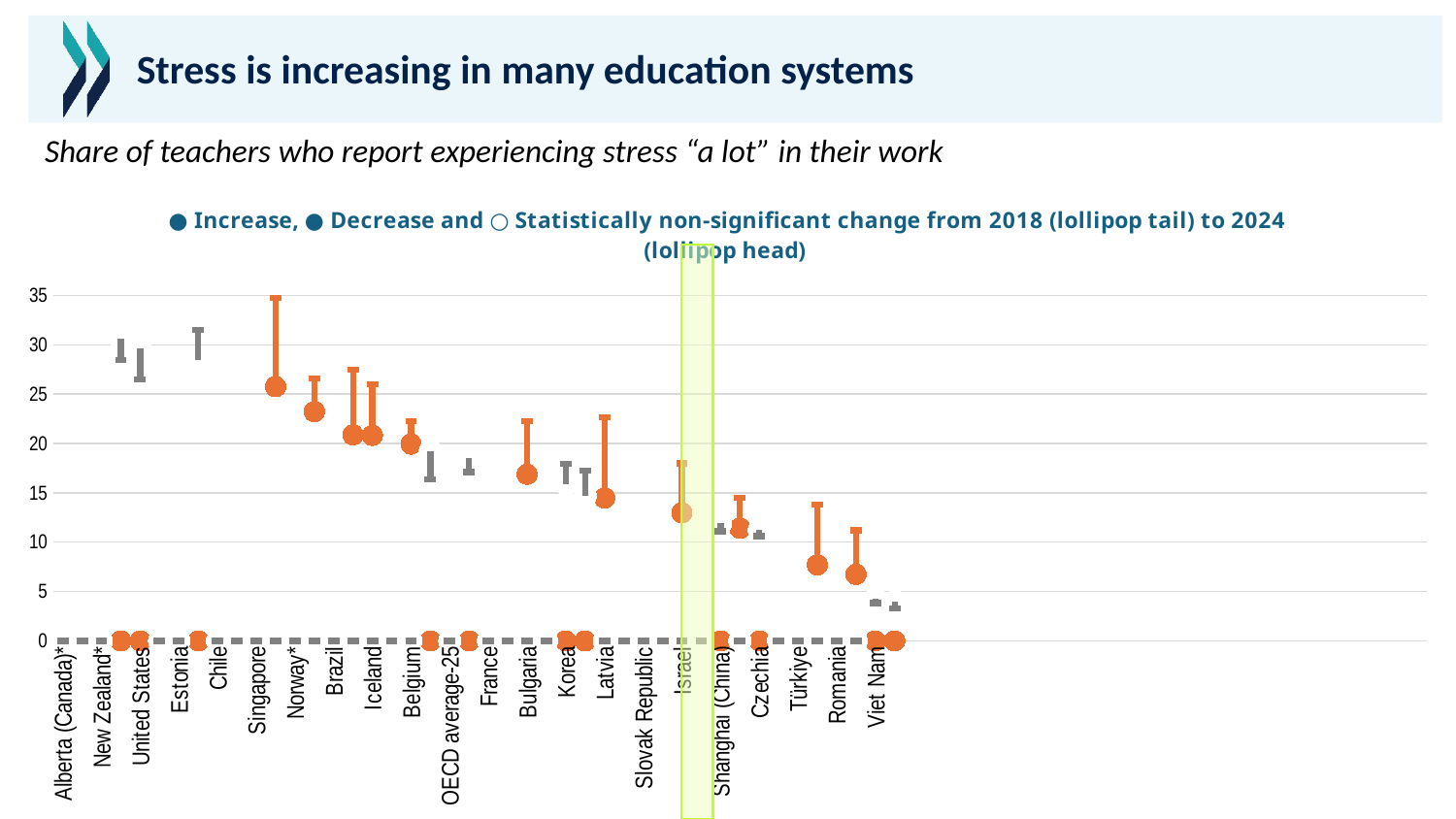
What does the chart measure, according to the subtitle? Share of teachers who report experiencing stress "a lot" in their work Is the 2024 value (lollipop head) for Latvia greater or less than 20? less How many countries or economies are listed along the x axis? 22 What kind of chart is shown on the slide? Lollipop chart Is the 2024 value (lollipop head) for Israel greater or less than 10? greater Which has the larger 2024 value (lollipop head), Norway or Türkiye? Norway Which has the larger 2024 value (lollipop head), Singapore or Romania? Singapore What is the title of the slide? Stress is increasing in many education systems Do the values generally rise or fall moving from left to right along the x axis? fall Is the 2024 value (lollipop head) for Türkiye greater or less than 10? less